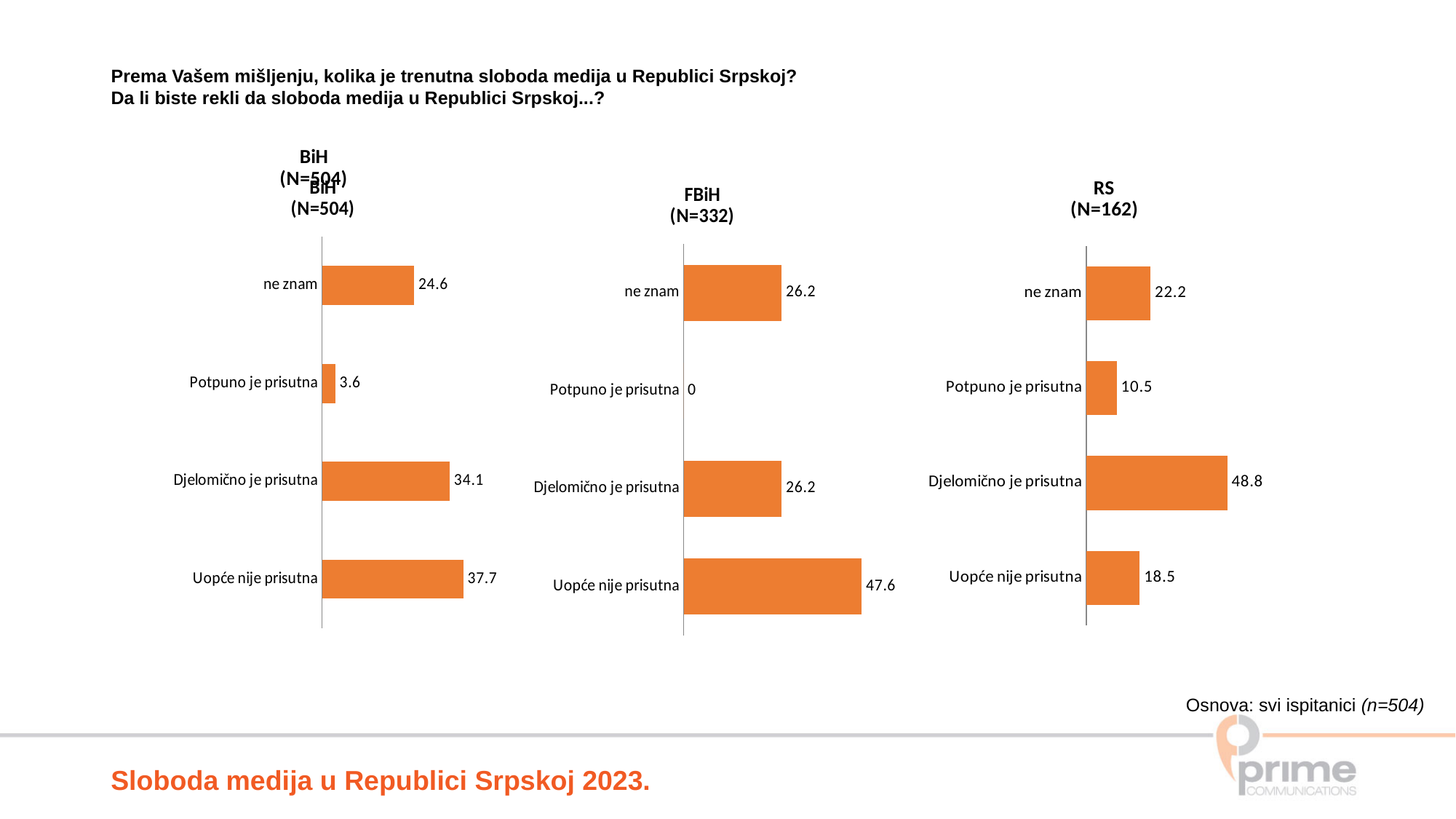
How many categories does the RS (N=162) chart show? 4 In the BiH (N=504) chart, what is the value for "Uopće nije prisutna"? 37.7 In the FBiH (N=332) chart, what is the difference between "Uopće nije prisutna" and "ne znam"? 21.4 In the BiH (N=504) chart, what is the difference between "Uopće nije prisutna" and "Djelomično je prisutna"? 3.6 In the FBiH (N=332) chart, what is the value for "Potpuno je prisutna"? 0 In the FBiH (N=332) chart, which category has the highest value? Uopće nije prisutna In the BiH (N=504) chart, which category has the lowest value? Potpuno je prisutna In the RS (N=162) chart, which category has the highest value? Djelomično je prisutna In the RS (N=162) chart, what is the value for "Djelomično je prisutna"? 48.8 What kind of chart is the FBiH (N=332) chart? Bar chart What colour are the bars in the BiH (N=504) chart? Orange In the RS (N=162) chart, which is larger: "ne znam" or "Uopće nije prisutna"? ne znam